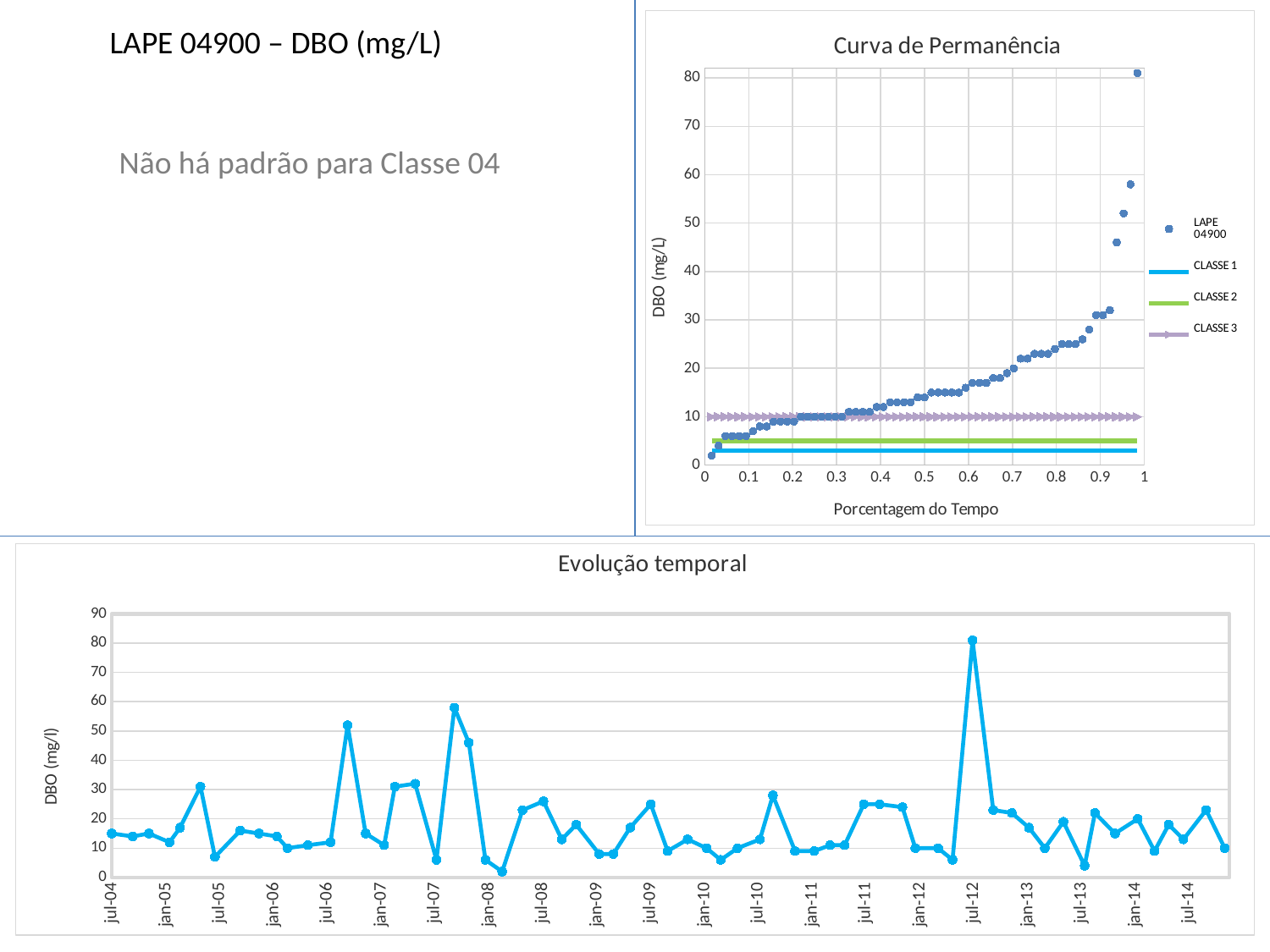
What is the title of the chart in the top-right of the slide? Curva de Permanência How many series does the legend of the 'Curva de Permanência' chart list? 4 In the 'Evolução temporal' chart, which is larger: the peak at jul-12 or the peak shortly after jul-06? the peak at jul-12 In the 'Curva de Permanência' chart, at what DBO value does the CLASSE 3 line sit? 10 In the 'Curva de Permanência' chart, do the LAPE 04900 values rise or fall as the x axis increases? rise In the 'Evolução temporal' chart, is the value at jul-12 greater or less than 70? greater In the 'Evolução temporal' chart, is the lowest value near jan-08 greater or less than 10? less In the 'Curva de Permanência' chart, is the highest LAPE 04900 point greater or less than 70? greater What is the x-axis label of the 'Curva de Permanência' chart? Porcentagem do Tempo What kind of chart is the 'Evolução temporal' chart at the bottom of the slide? line chart In the 'Evolução temporal' chart, at which date does the highest value occur? jul-12